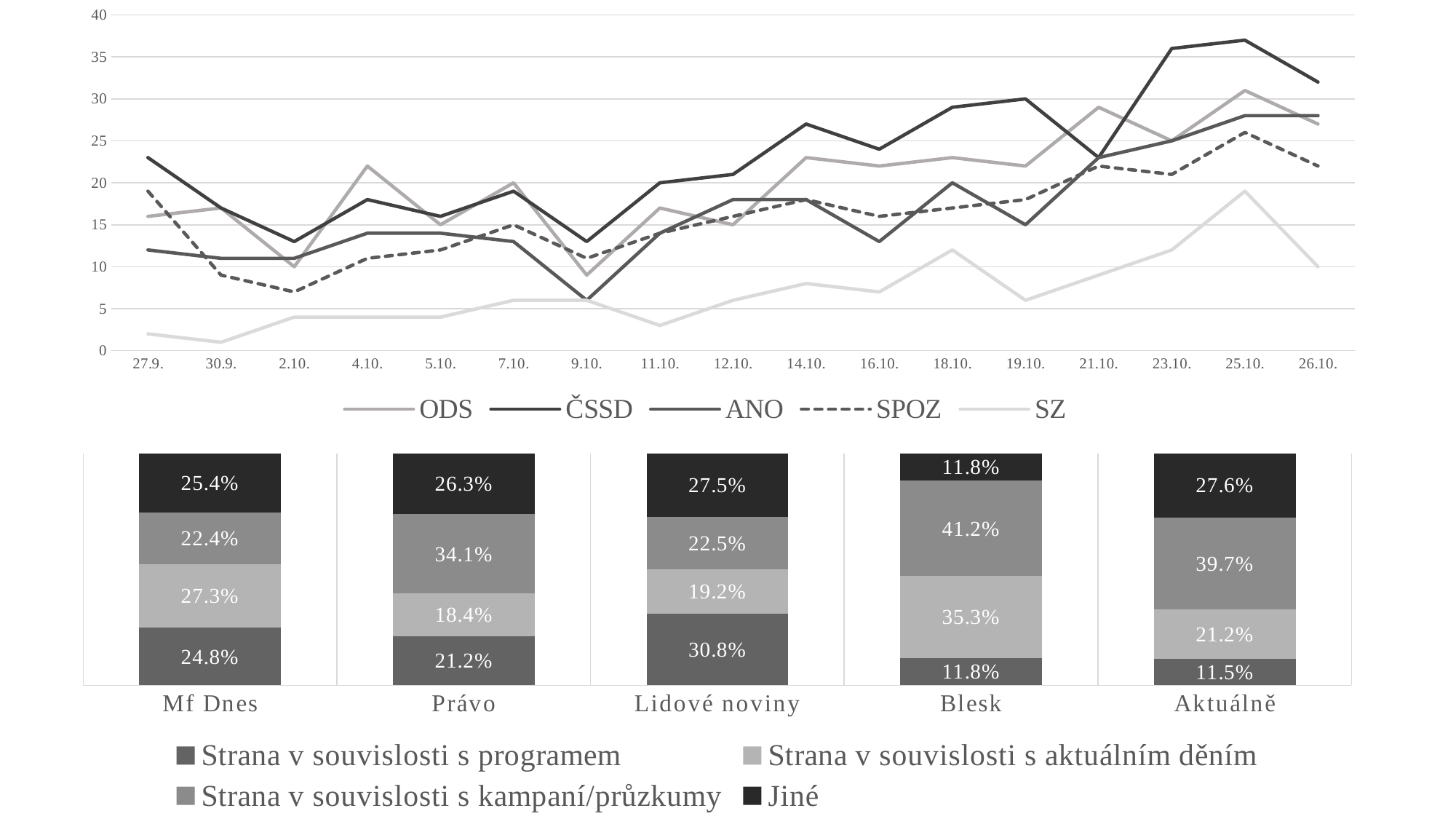
How many dates are shown on the x axis of the top line chart? 17 What kind of chart is the top chart on the slide? line chart In the bottom stacked bar chart, which category has the highest value for 'Strana v souvislosti s programem'? Lidové noviny How many series does the legend of the top line chart list? 5 In the bottom stacked bar chart, what is the value of 'Strana v souvislosti s kampaní/průzkumy' for Blesk? 41.2% In the bottom stacked bar chart, which category has the lowest value for 'Jiné'? Blesk In the bottom stacked bar chart, what is the difference between the 'Strana v souvislosti s kampaní/průzkumy' values for Právo and Mf Dnes? 11.7 percentage points In the top line chart, is the value for ČSSD on 25.10. greater or less than 35? greater What kind of chart is the bottom chart on the slide? bar chart In the bottom stacked bar chart, which has the larger 'Strana v souvislosti s aktuálním děním' value, Aktuálně or Lidové noviny? Aktuálně In the top line chart, is the value for SZ on 9.10. greater or less than 10? less In the bottom stacked bar chart, what is the value of 'Jiné' for Mf Dnes? 25.4%